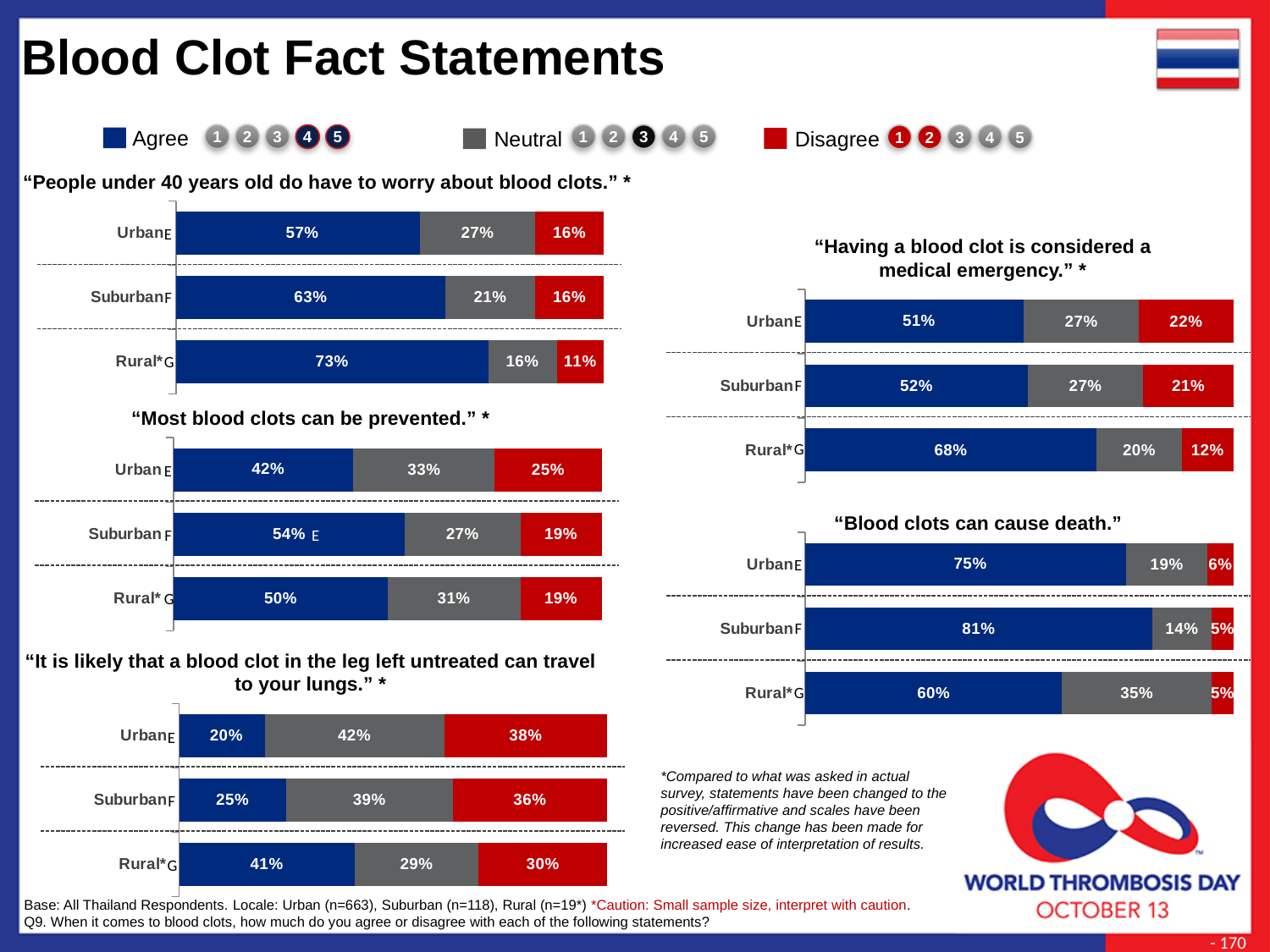
In the chart "It is likely that a blood clot in the leg left untreated can travel to your lungs.", which locale has the lowest Agree percentage? Urban In the chart "Having a blood clot is considered a medical emergency.", what percentage of Rural respondents disagree? 12% In the chart "Most blood clots can be prevented.", what is the difference between the Suburban and Urban Agree percentages? 12% In the chart "It is likely that a blood clot in the leg left untreated can travel to your lungs.", what percentage of Urban respondents disagree? 38% How many series does the legend at the top of the slide list? 3 In the chart "Having a blood clot is considered a medical emergency.", is the Agree percentage larger for Rural or Urban? Rural In the chart "People under 40 years old do have to worry about blood clots.", which locale has the highest Agree percentage? Rural What type of chart is used for "Blood clots can cause death."? Stacked bar chart In the chart "Blood clots can cause death.", what percentage of Suburban respondents agree? 81% In the chart "Most blood clots can be prevented.", what percentage of Urban respondents are Neutral? 33% In the chart "People under 40 years old do have to worry about blood clots.", what percentage of Rural respondents agree? 73% In the chart "Blood clots can cause death.", which locale has the highest Neutral percentage? Rural